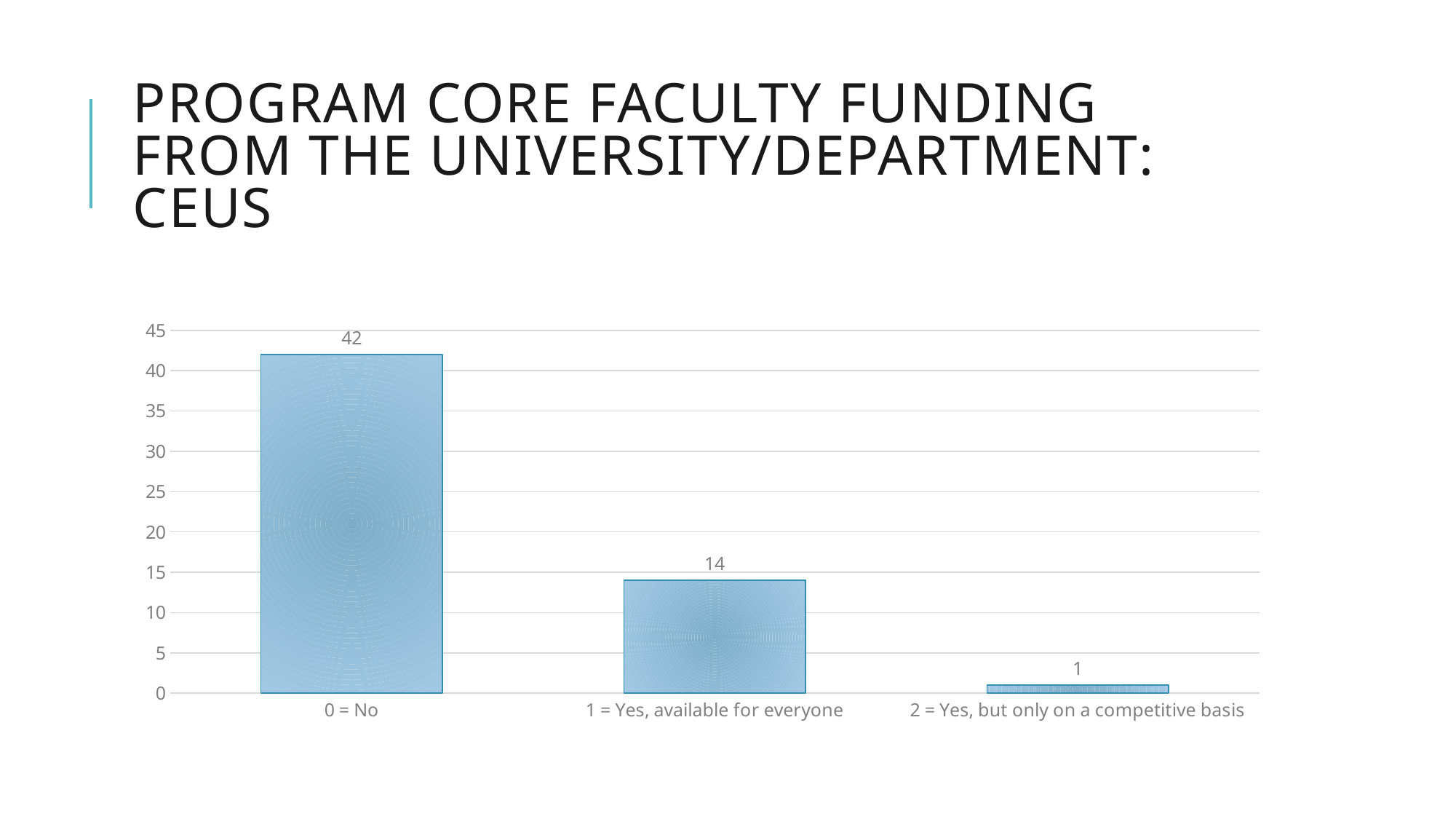
What is the value for "2 = Yes, but only on a competitive basis"? 1 Is the value for "0 = No" greater or less than 40? greater What is the value for "1 = Yes, available for everyone"? 14 Do the values rise or fall from left to right along the x axis? fall What is the value for "0 = No"? 42 What is the difference between the values for "1 = Yes, available for everyone" and "2 = Yes, but only on a competitive basis"? 13 Which category has the lowest value? 2 = Yes, but only on a competitive basis What kind of chart is shown on the slide? bar chart How many categories are shown on the x axis? 3 Which category has the highest value? 0 = No Which is larger, the value for "0 = No" or the value for "1 = Yes, available for everyone"? 0 = No What is the difference between the values for "0 = No" and "1 = Yes, available for everyone"? 28